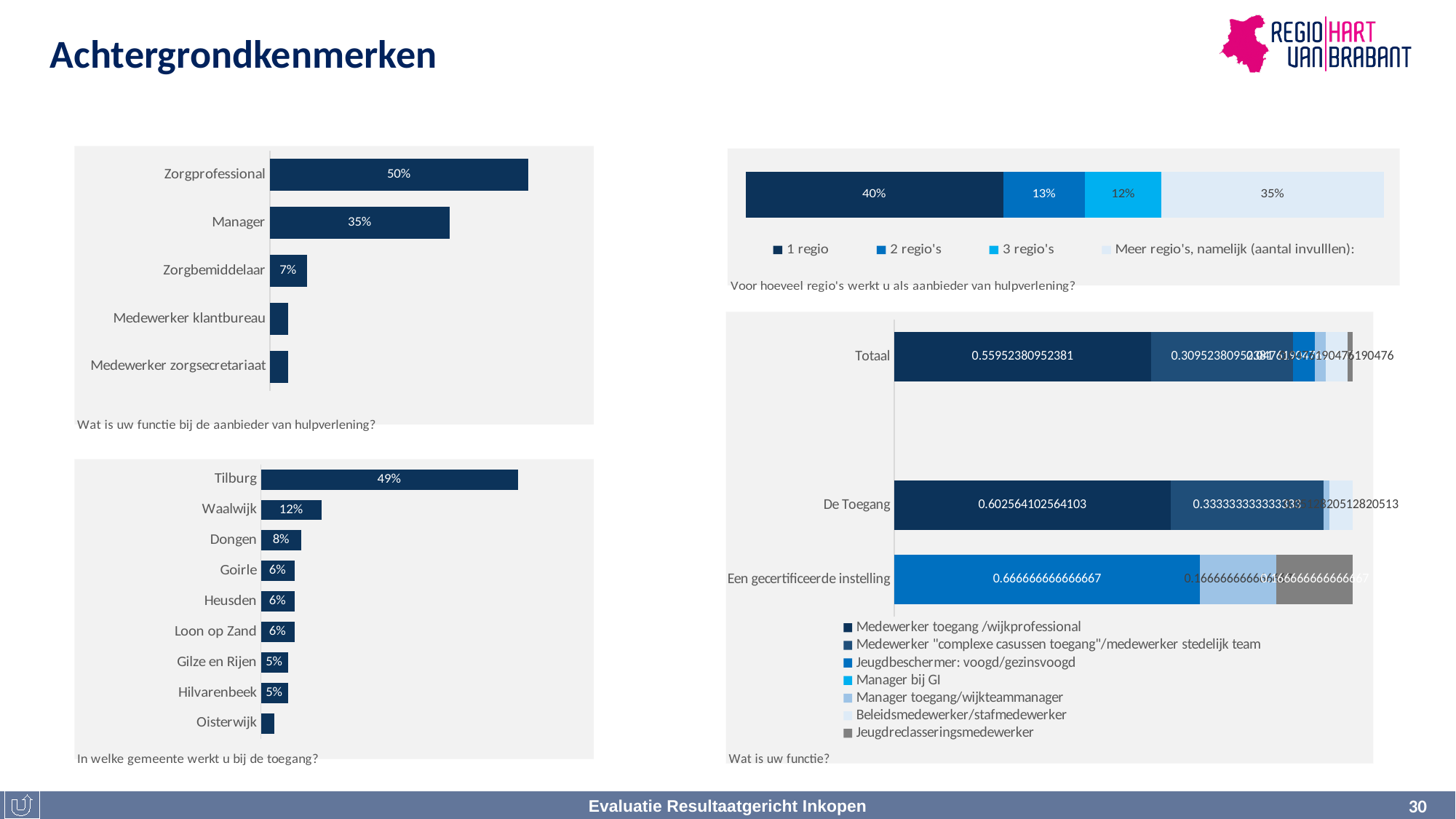
In the chart 'Voor hoeveel regio's werkt u als aanbieder van hulpverlening?', how many series does the legend list? 4 In the chart 'Wat is uw functie?', what is the value of the first segment (Medewerker toegang /wijkprofessional) for De Toegang? 0.602564102564103 In the chart 'Wat is uw functie bij de aanbieder van hulpverlening?', what is the difference between Zorgprofessional and Zorgbemiddelaar? 43% In the chart 'Wat is uw functie bij de aanbieder van hulpverlening?', what is the value for Manager? 35% In the chart 'Voor hoeveel regio's werkt u als aanbieder van hulpverlening?', what is the share for 2 regio's? 13% In the chart 'In welke gemeente werkt u bij de toegang?', which gemeente has the highest value? Tilburg In the chart 'In welke gemeente werkt u bij de toegang?', what is the value for Waalwijk? 12% In the chart 'Wat is uw functie bij de aanbieder van hulpverlening?', how many categories are shown? 5 In the chart 'Wat is uw functie bij de aanbieder van hulpverlening?', what is the value for Zorgprofessional? 50% In the chart 'In welke gemeente werkt u bij de toegang?', how many gemeenten are listed? 9 In the chart 'Wat is uw functie?', how many series does the legend list? 7 In the chart 'In welke gemeente werkt u bij de toegang?', which is larger, Dongen or Gilze en Rijen? Dongen